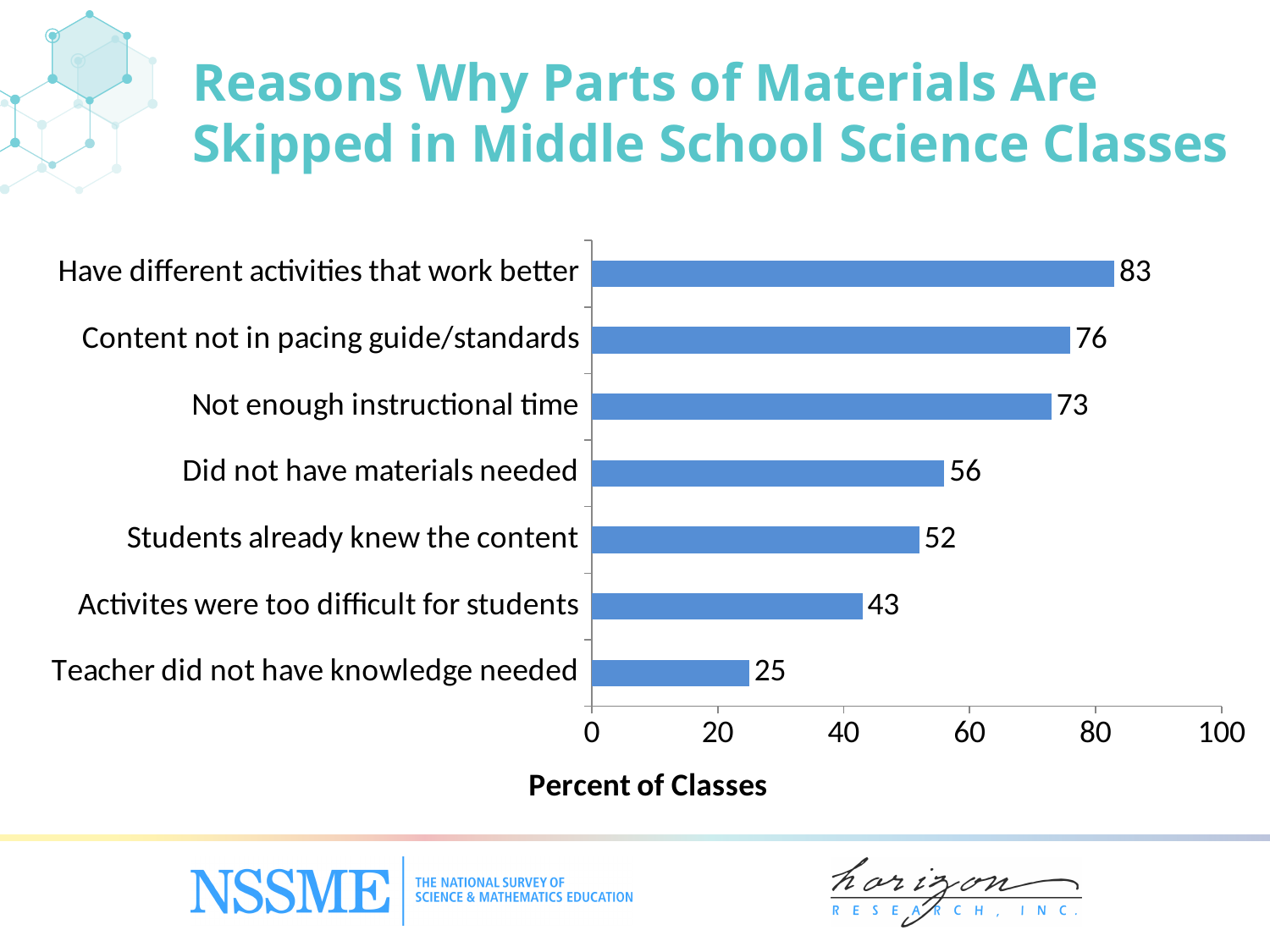
What is the value for "Teacher did not have knowledge needed"? 25 What kind of chart is shown on the slide? Bar chart Which reason has the lowest percent of classes? Teacher did not have knowledge needed What is the value for "Did not have materials needed"? 56 What is the label of the horizontal axis? Percent of Classes How many reasons are shown on the chart? 7 What percent of classes skipped parts of materials because they have different activities that work better? 83 What is the difference between the highest and lowest values on the chart? 58 Which is larger: "Students already knew the content" or "Activites were too difficult for students"? Students already knew the content Which reason has the highest percent of classes? Have different activities that work better Is the value for "Not enough instructional time" greater or less than 60? greater What is the difference between "Content not in pacing guide/standards" and "Not enough instructional time"? 3